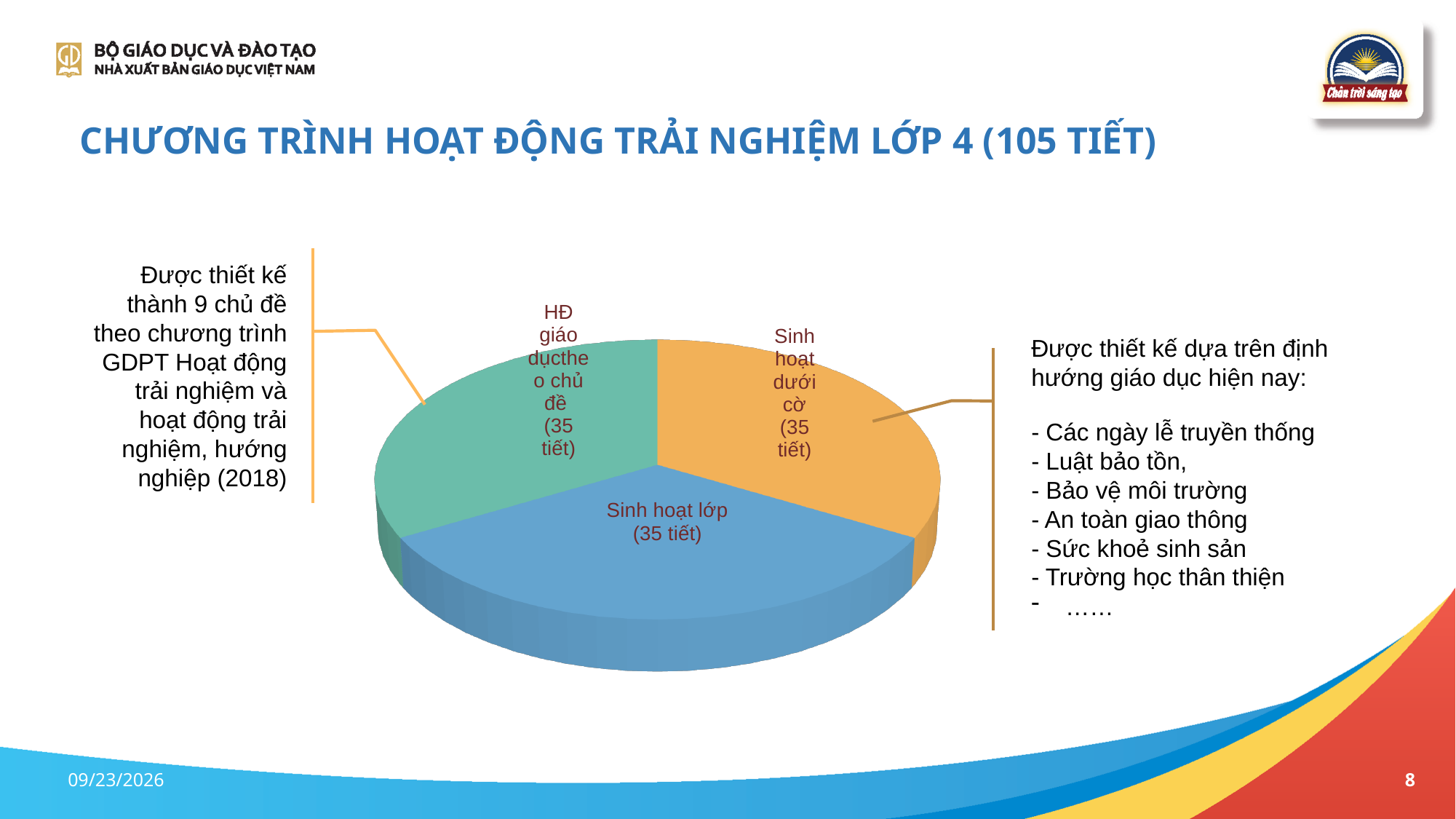
What is the difference in tiết between Sinh hoạt lớp and Sinh hoạt dưới cờ? 0 What is the total number of tiết across all three slices of the pie chart? 105 tiết How many tiết are allocated to HĐ giáo dục theo chủ đề in the pie chart? 35 tiết What share of the pie chart does Sinh hoạt lớp represent? One third How many tiết are allocated to Sinh hoạt lớp in the pie chart? 35 tiết Is the value for Sinh hoạt lớp greater or less than 30 tiết? greater How many slices does the pie chart have? 3 Which colour is the Sinh hoạt lớp slice in the pie chart? Blue How many tiết are allocated to Sinh hoạt dưới cờ in the pie chart? 35 tiết What kind of chart is shown on the slide? Pie chart Which colour is the Sinh hoạt dưới cờ slice in the pie chart? Orange